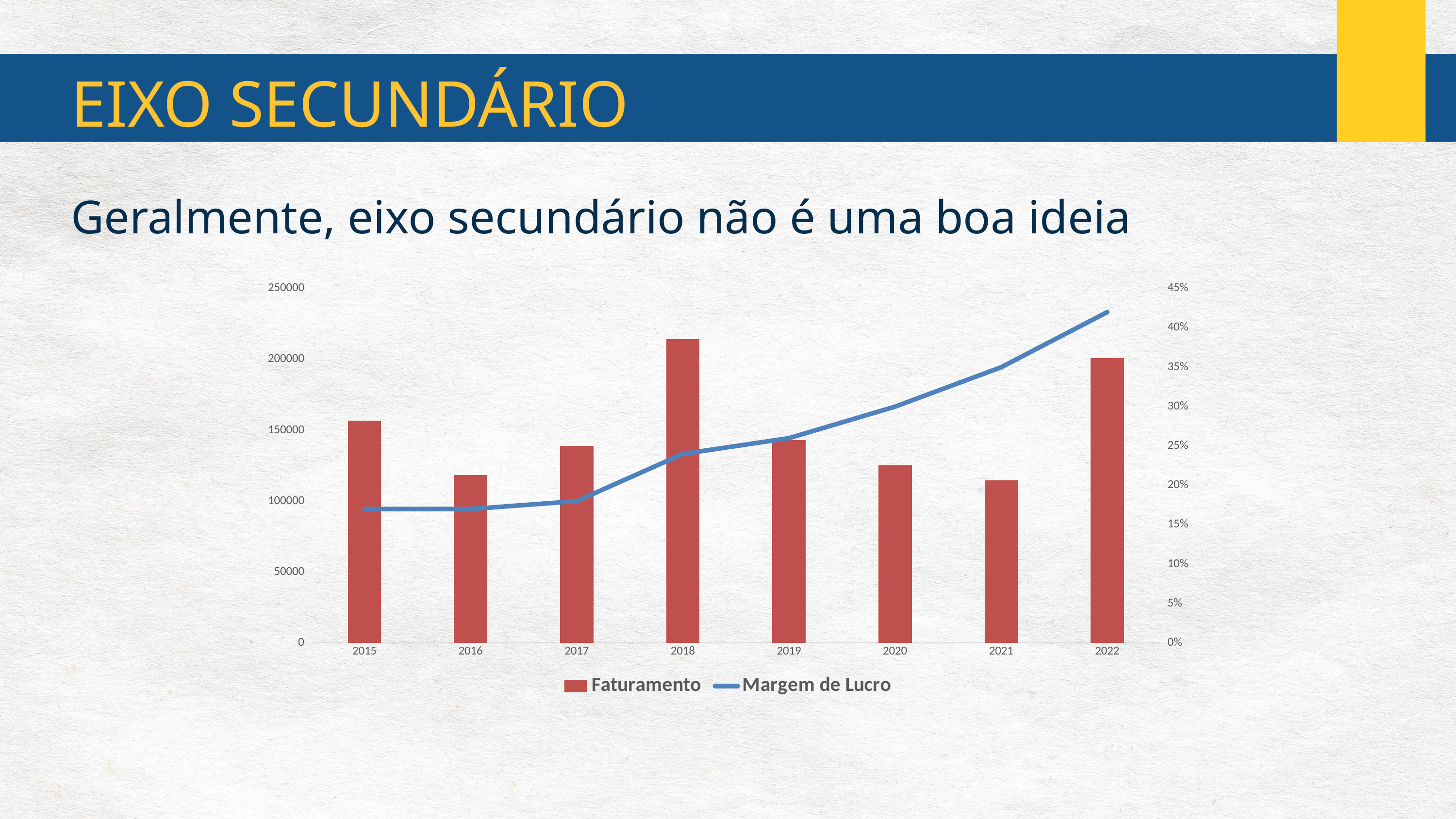
Is the Margem de Lucro value for 2015 greater or less than 20%? less How many years are shown on the x axis of the chart? 8 Is the Margem de Lucro value for 2022 greater or less than 40%? greater Which year has the larger Faturamento bar, 2018 or 2022? 2018 How many series does the chart legend list? 2 Which series is drawn as a line in the chart? Margem de Lucro What kind of chart is shown on the slide? Combined bar and line chart Does the Margem de Lucro line generally rise or fall from 2015 to 2022? rise Is the Faturamento value for 2021 greater or less than 150000? less Which year has the highest Margem de Lucro value? 2022 Which year has the highest Faturamento bar? 2018